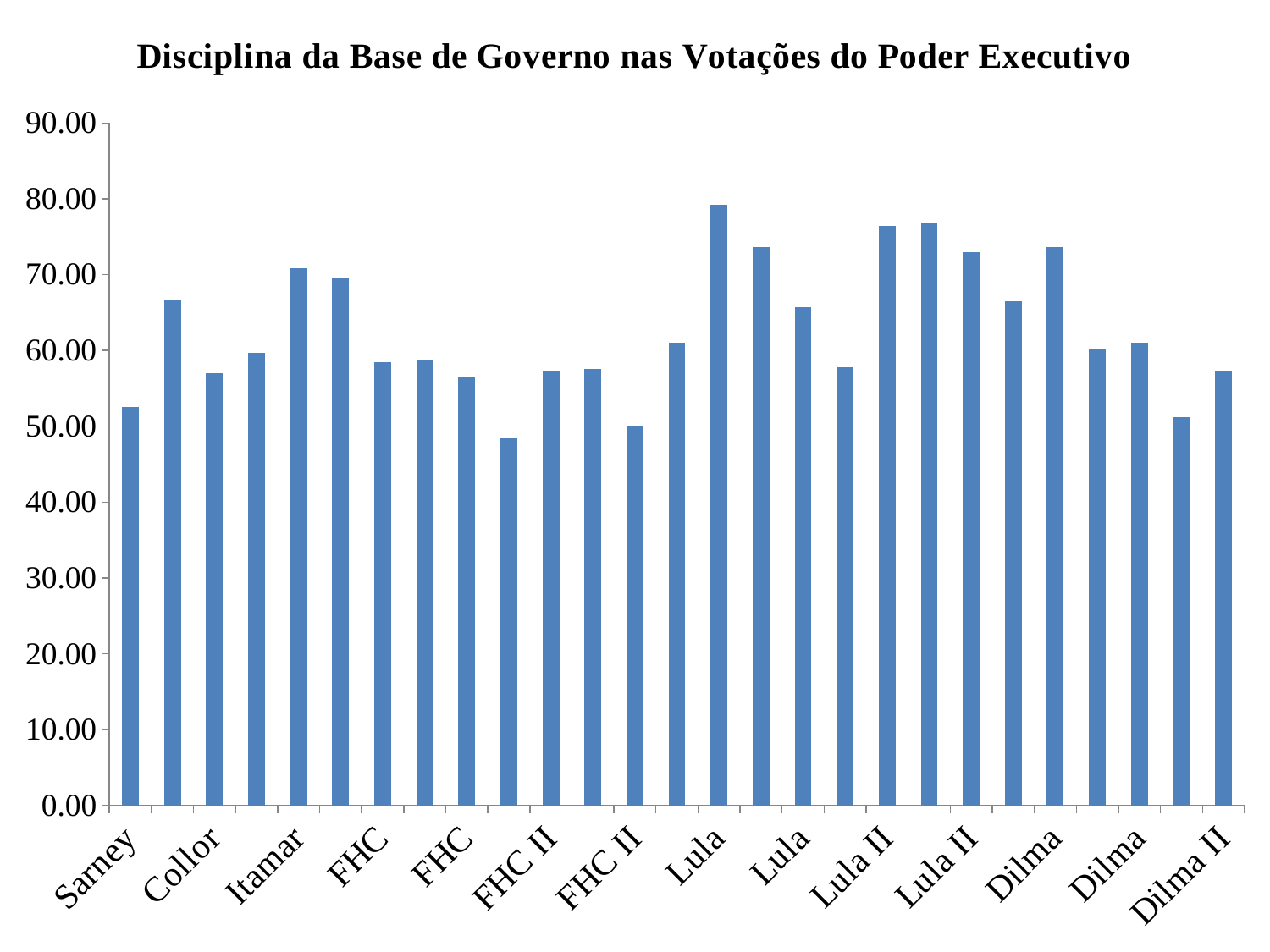
What is the title of the chart? Disciplina da Base de Governo nas Votações do Poder Executivo Is the value for Itamar greater or less than 60? greater Is the value for Sarney greater or less than 50? greater Which is larger, the value for Sarney or the value for Collor? Collor Which labeled category has the tallest bar in the chart? Lula Which is larger, the value for Itamar or the value for Collor? Itamar What is the highest value shown on the y axis? 90.00 What type of chart is shown on the slide? Bar chart Is the lowest bar in the chart greater or less than 50? less